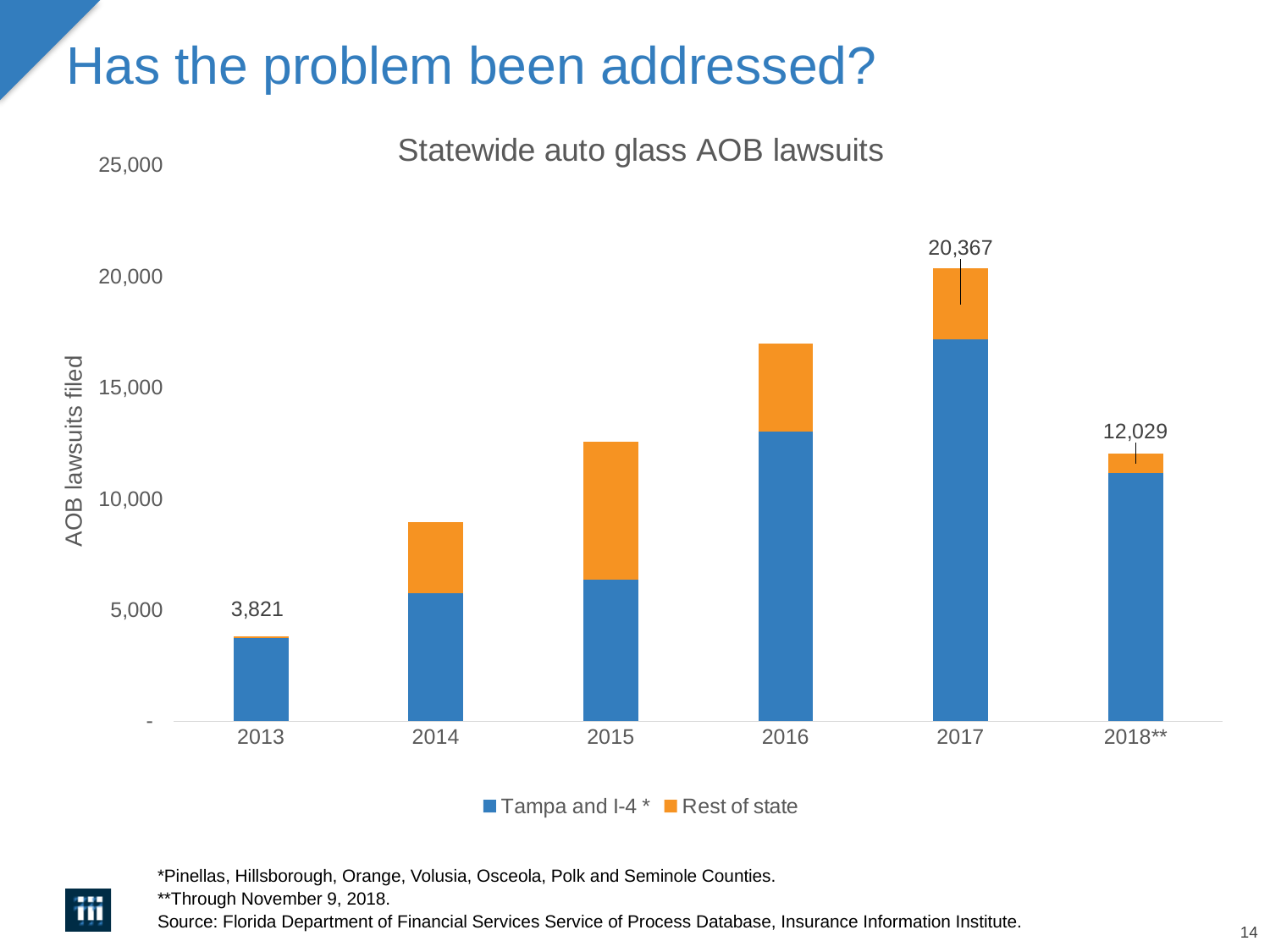
How many years are shown on the x axis of the chart? 6 Which year has the larger total of AOB lawsuits, 2015 or 2016? 2016 By how much did the total number of AOB lawsuits fall from 2017 to 2018**? 8,338 What is the total number of statewide auto glass AOB lawsuits shown for 2017? 20,367 Is the total value for 2016 greater or less than 15,000? greater How many series does the legend list? 2 Which year has the lowest total of AOB lawsuits filed? 2013 What is the total number of AOB lawsuits shown for 2018**? 12,029 Which year has the highest total of AOB lawsuits filed? 2017 What is the total number of AOB lawsuits shown for 2013? 3,821 What kind of chart is shown on the slide? Stacked bar chart What are the two series named in the legend? Tampa and I-4 * and Rest of state